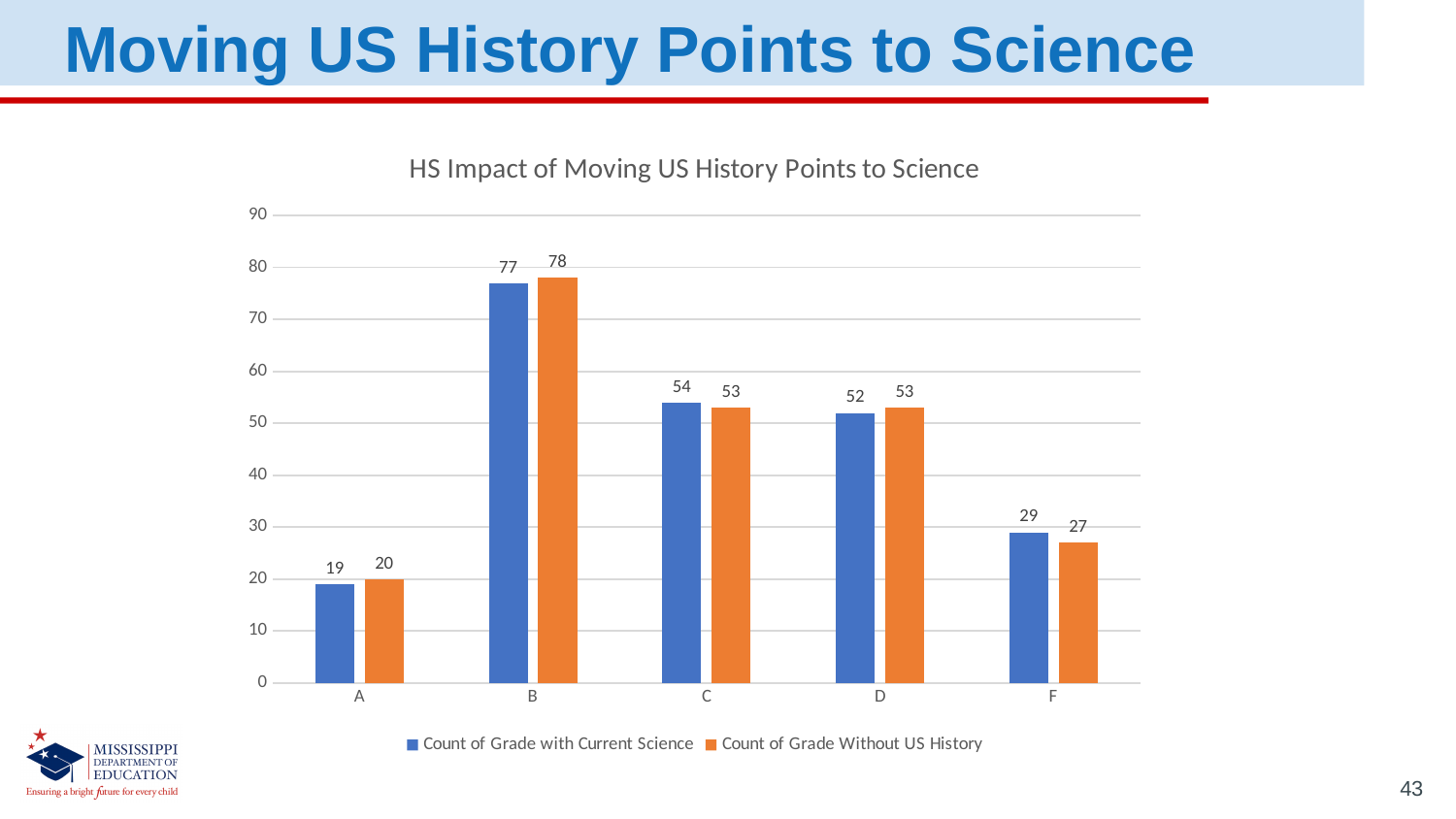
Which grade has the highest Count of Grade Without US History? B How many series does the legend list? 2 What is the title of the chart? HS Impact of Moving US History Points to Science What is the Count of Grade with Current Science for grade D? 52 Which colour represents the Count of Grade Without US History series? Orange How many grade categories are shown on the x axis? 5 What is the Count of Grade Without US History for grade F? 27 Which is larger for grade C: the Count of Grade with Current Science or the Count of Grade Without US History? Count of Grade with Current Science What is the difference between the Count of Grade with Current Science and the Count of Grade Without US History for grade F? 2 What kind of chart is shown on the slide? Bar chart Which grade has the lowest Count of Grade with Current Science? A What is the Count of Grade with Current Science for grade B? 77